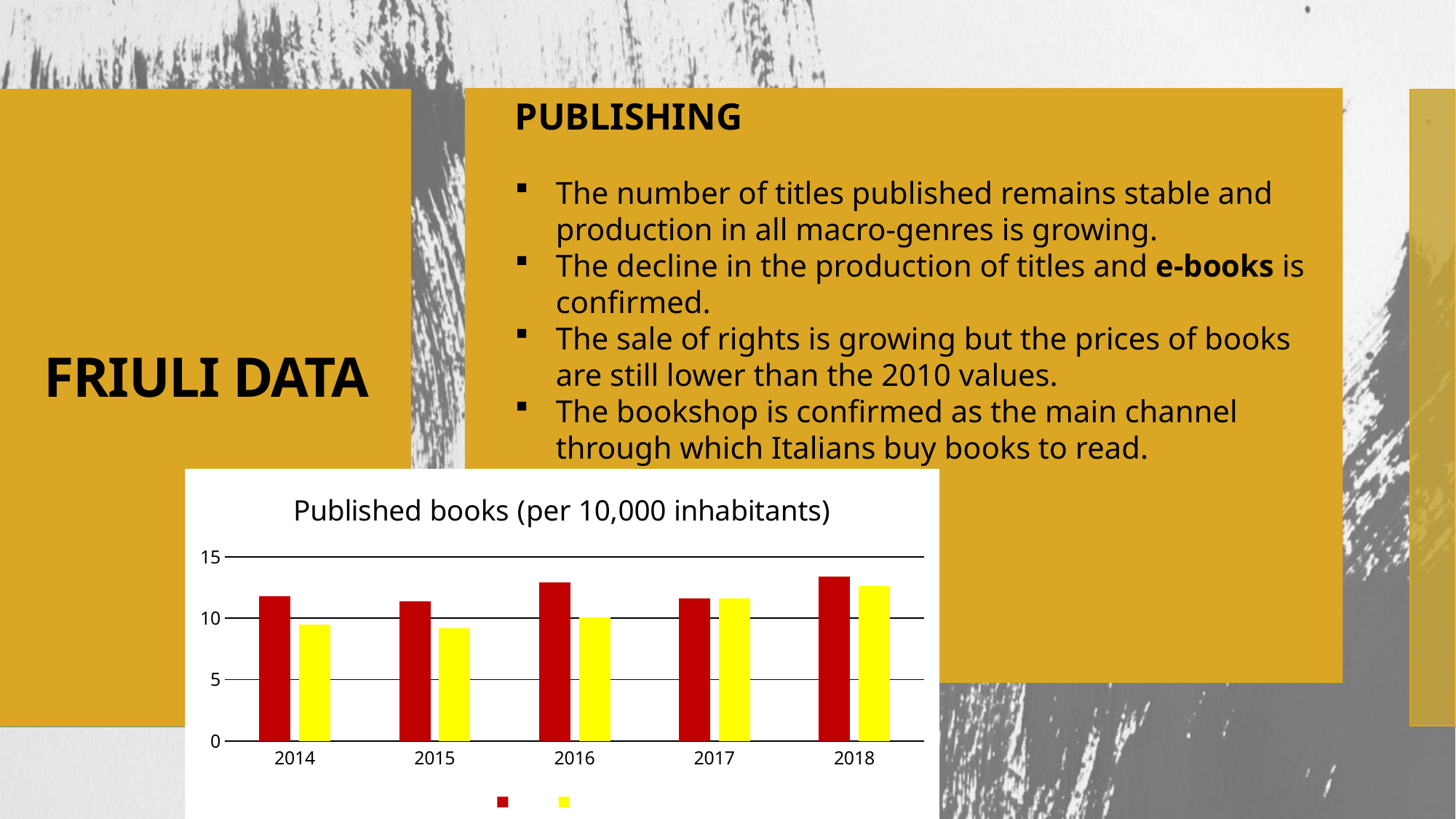
What kind of chart is shown on the slide? bar chart Is the value of the red bar for 2018 greater or less than 15? less In 2014, which bar is larger, the red one or the yellow one? the red one Is the value of the yellow bar for 2015 greater or less than 10? less Is the value of the red bar for 2014 greater or less than 10? greater What is the title of the chart? Published books (per 10,000 inhabitants) Do the yellow bars rise or fall from 2015 to 2018? rise How many series does the chart's legend list? 2 In which year is the red bar the highest? 2018 How many years are shown on the x axis of the chart? 5 What colours are the two series in the chart? red and yellow